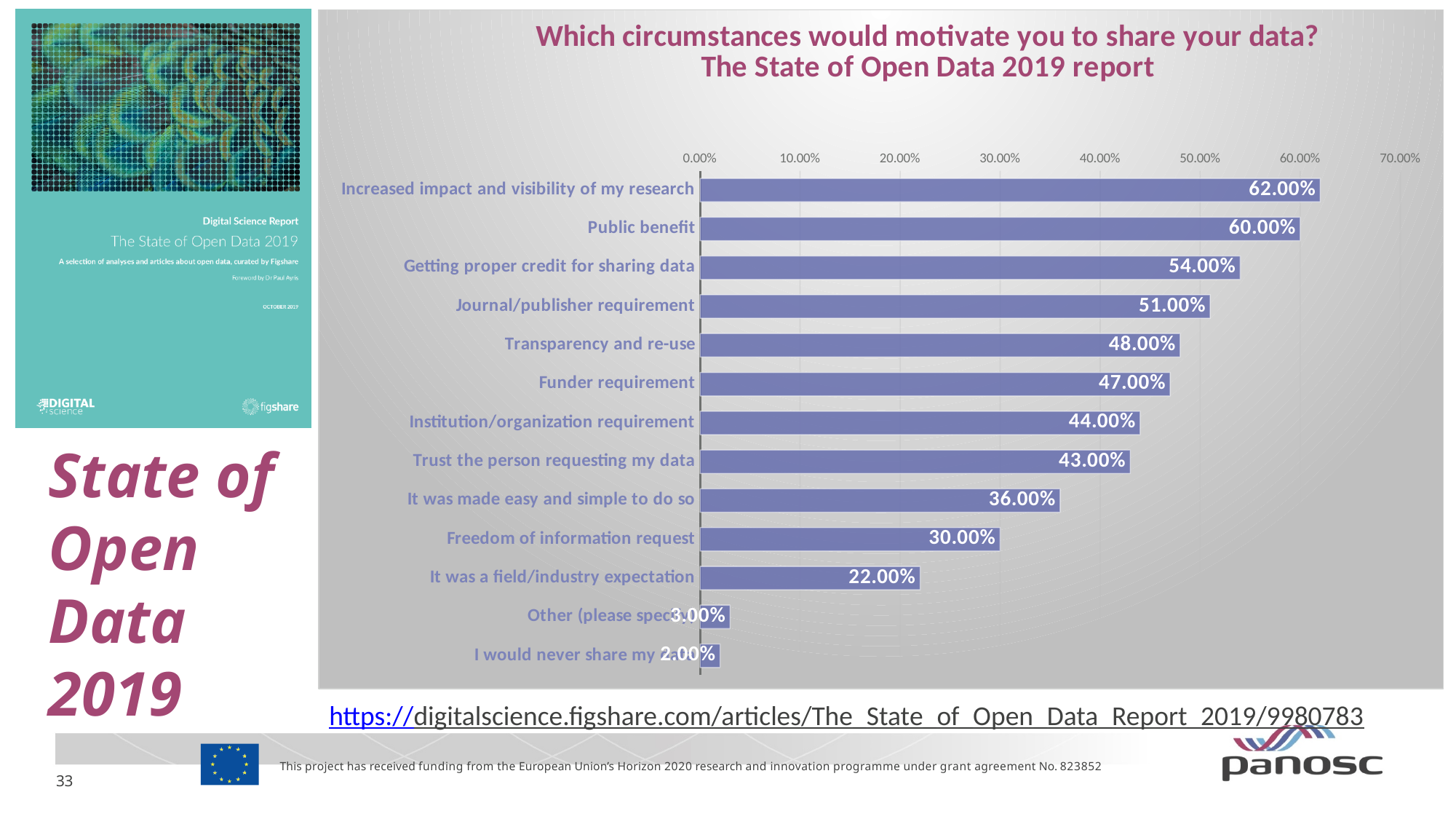
Is the value for 'Freedom of information request' greater or less than 40.00%? less Which category has the highest value? Increased impact and visibility of my research What is the difference between 'Public benefit' and 'Getting proper credit for sharing data'? 6.00% What is the value for 'Increased impact and visibility of my research'? 62.00% What is the value for 'Journal/publisher requirement'? 51.00% What is the value for 'It was made easy and simple to do so'? 36.00% What is the title of the chart? Which circumstances would motivate you to share your data? The State of Open Data 2019 report How many categories are shown in the chart? 13 Which category has the lowest value? I would never share my data What is the difference between 'Transparency and re-use' and 'It was a field/industry expectation'? 26.00% Which is larger, 'Funder requirement' or 'Institution/organization requirement'? Funder requirement What kind of chart is shown on the slide? bar chart